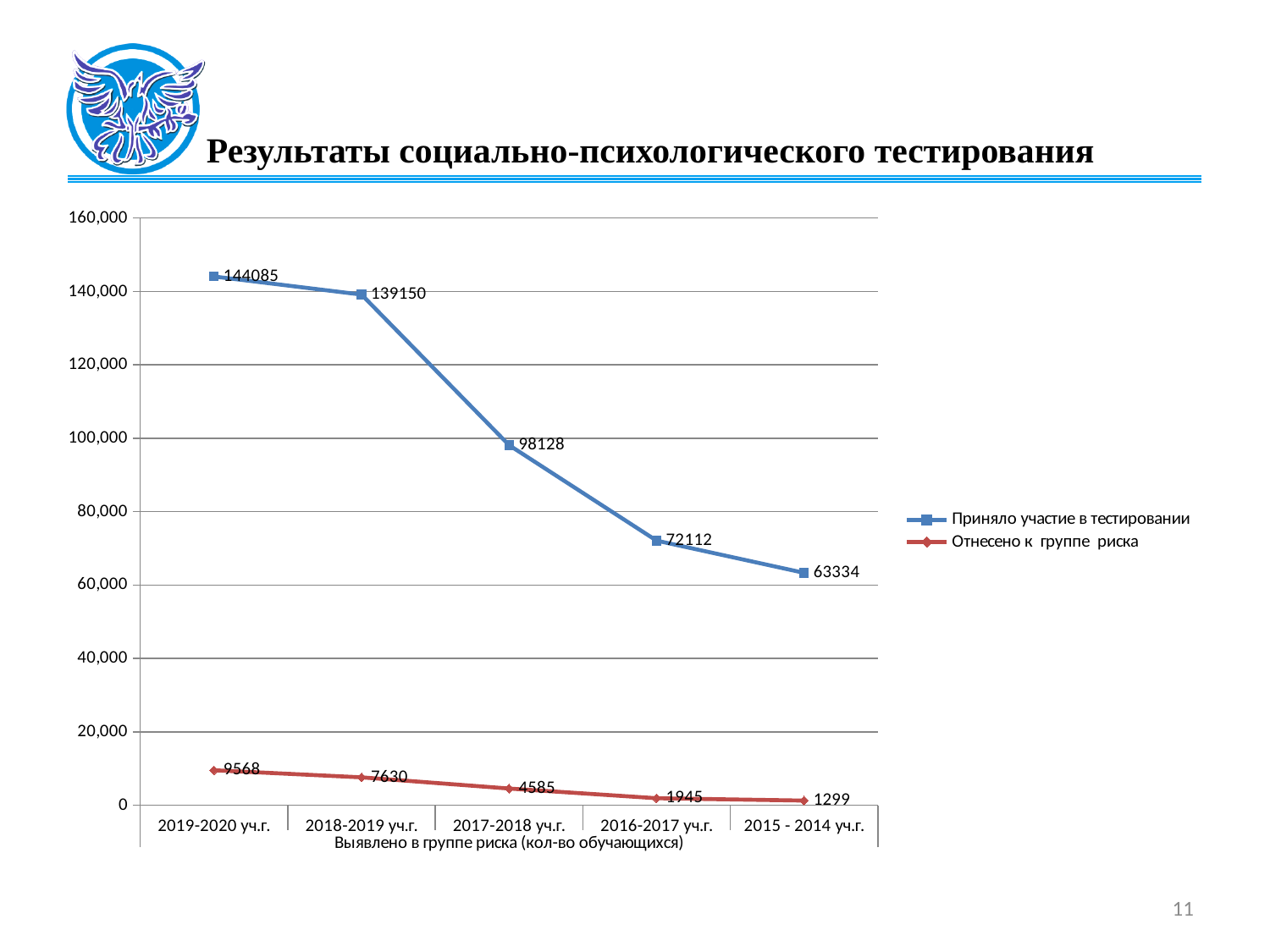
Does 'Приняло участие в тестировании' rise or fall moving from left to right along the x axis? fall What is the difference between 'Приняло участие в тестировании' in 2019-2020 уч.г. and 2018-2019 уч.г.? 4935 Is the value of 'Приняло участие в тестировании' for 2017-2018 уч.г. greater or less than 100,000? less In which academic year is 'Приняло участие в тестировании' the highest? 2019-2020 уч.г. What type of chart is shown on the slide? line chart How many academic-year categories are shown on the x axis? 5 In which academic year is 'Отнесено к группе риска' the lowest? 2015 - 2014 уч.г. What is the value of 'Приняло участие в тестировании' for 2015 - 2014 уч.г.? 63334 What is the value of 'Отнесено к группе риска' for 2017-2018 уч.г.? 4585 What is the value of 'Приняло участие в тестировании' for 2019-2020 уч.г.? 144085 How many series does the legend list? 2 Which is larger: 'Отнесено к группе риска' in 2018-2019 уч.г. or in 2016-2017 уч.г.? 2018-2019 уч.г.